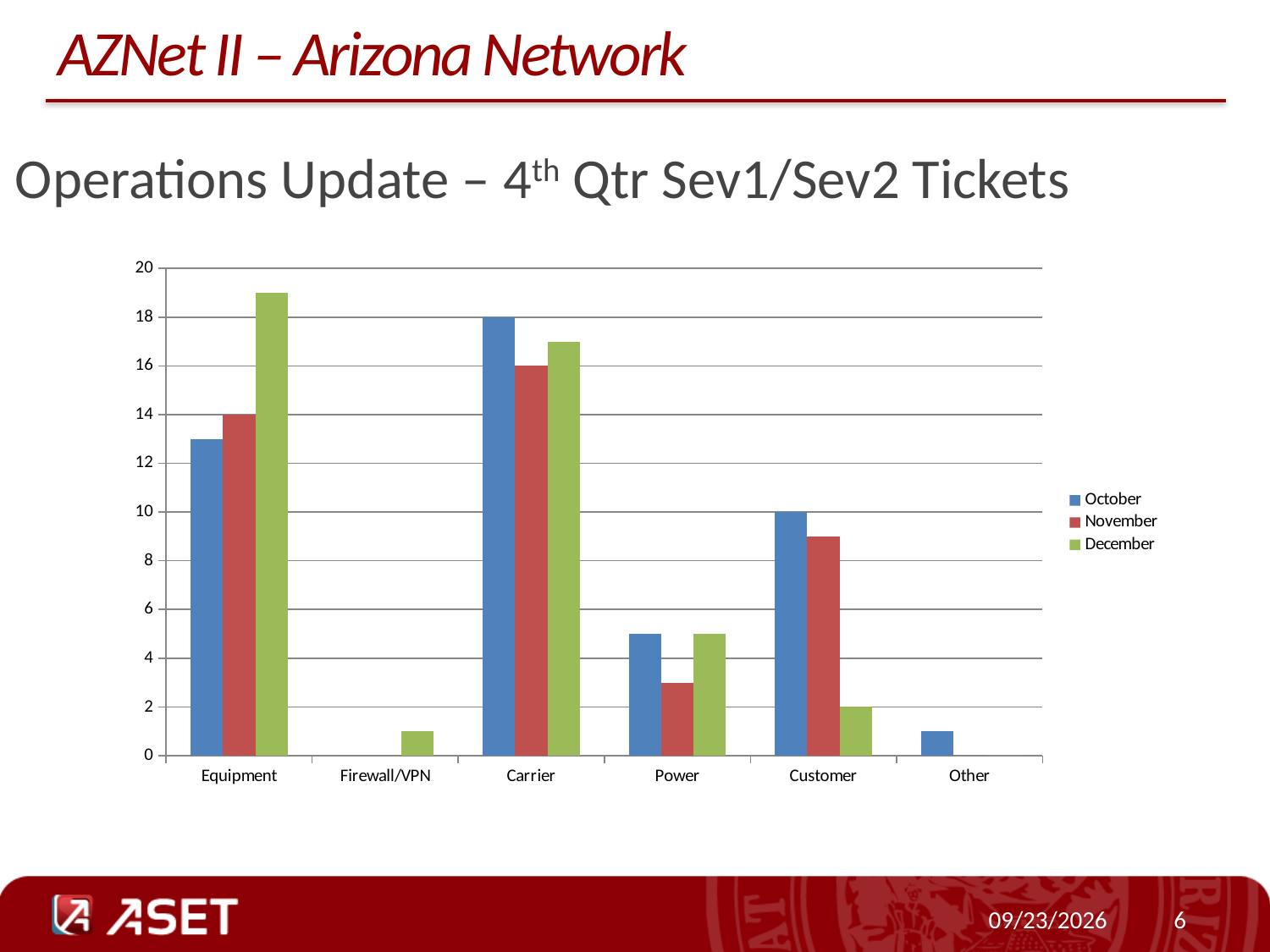
What is the December value for Customer? 2 What is the October value for Carrier? 18 Which category has the lowest October value? Firewall/VPN What is the October value for Customer? 10 What is the difference between the October and November values for Carrier? 2 How many categories are shown on the x axis? 6 Do the values for Customer rise or fall from October to December? fall How many series does the legend list? 3 What type of chart is shown on the slide? bar chart What is the November value for Equipment? 14 Which category has the highest December value? Equipment Is the December value for Equipment greater or less than 18? greater